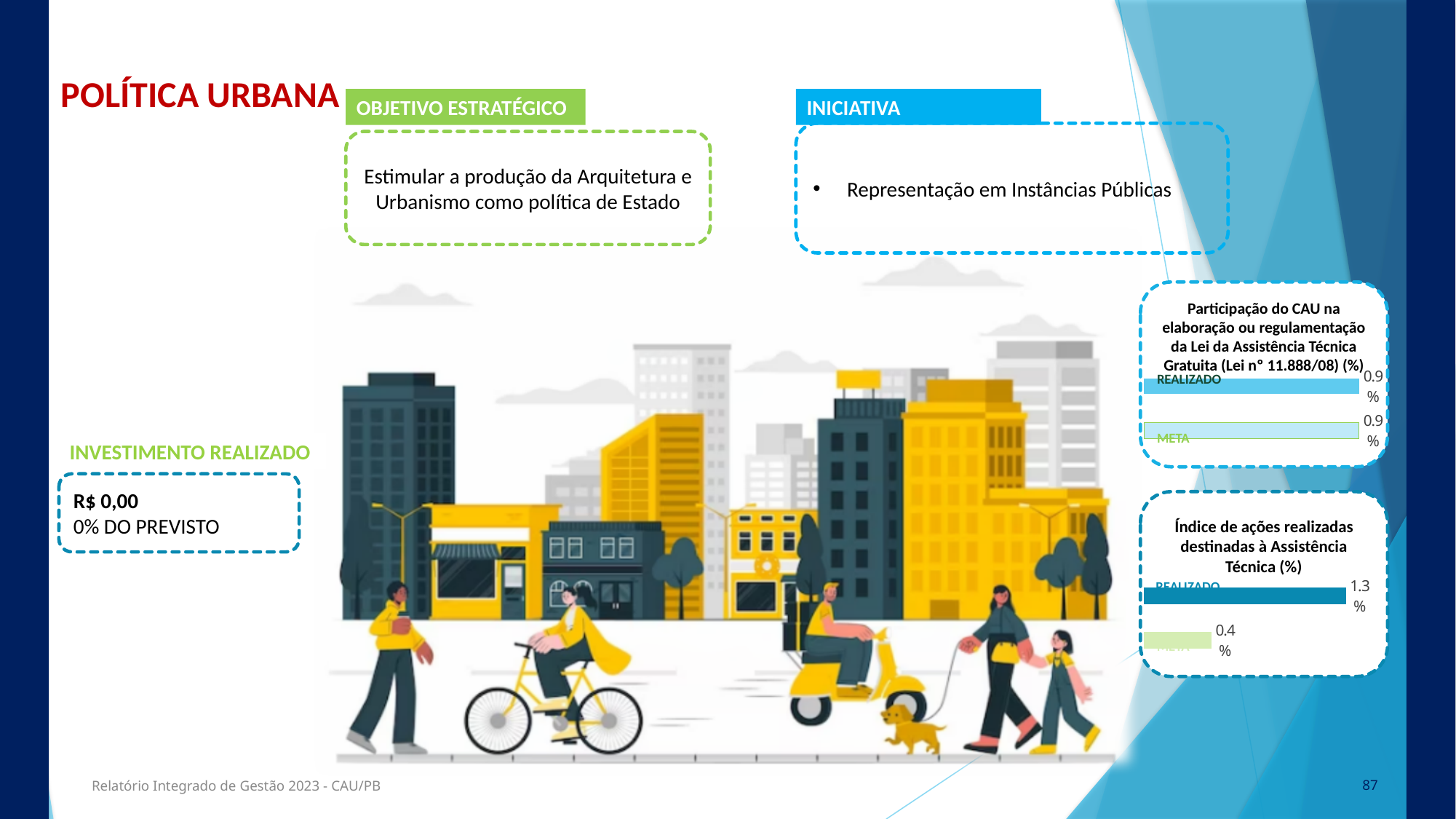
In the chart titled 'Índice de ações realizadas destinadas à Assistência Técnica (%)', what is the value for META? 0.4% What is the title of the upper chart on the right side of the slide? Participação do CAU na elaboração ou regulamentação da Lei da Assistência Técnica Gratuita (Lei nº 11.888/08) (%) In the chart titled 'Índice de ações realizadas destinadas à Assistência Técnica (%)', what is the value for REALIZADO? 1.3% In the chart titled 'Participação do CAU na elaboração ou regulamentação da Lei da Assistência Técnica Gratuita', what is the value for META? 0.9% How many charts are shown on the slide? 2 In the chart titled 'Índice de ações realizadas destinadas à Assistência Técnica (%)', what is the difference between REALIZADO and META? 0.9% In the chart titled 'Índice de ações realizadas destinadas à Assistência Técnica (%)', which category has the lowest value? META What type of chart is the lower chart on the right side of the slide? Bar chart In the chart titled 'Participação do CAU na elaboração ou regulamentação da Lei da Assistência Técnica Gratuita', what is the value for REALIZADO? 0.9% How many bars are shown in the chart titled 'Índice de ações realizadas destinadas à Assistência Técnica (%)'? 2 In the chart titled 'Índice de ações realizadas destinadas à Assistência Técnica (%)', which bar is higher, REALIZADO or META? REALIZADO